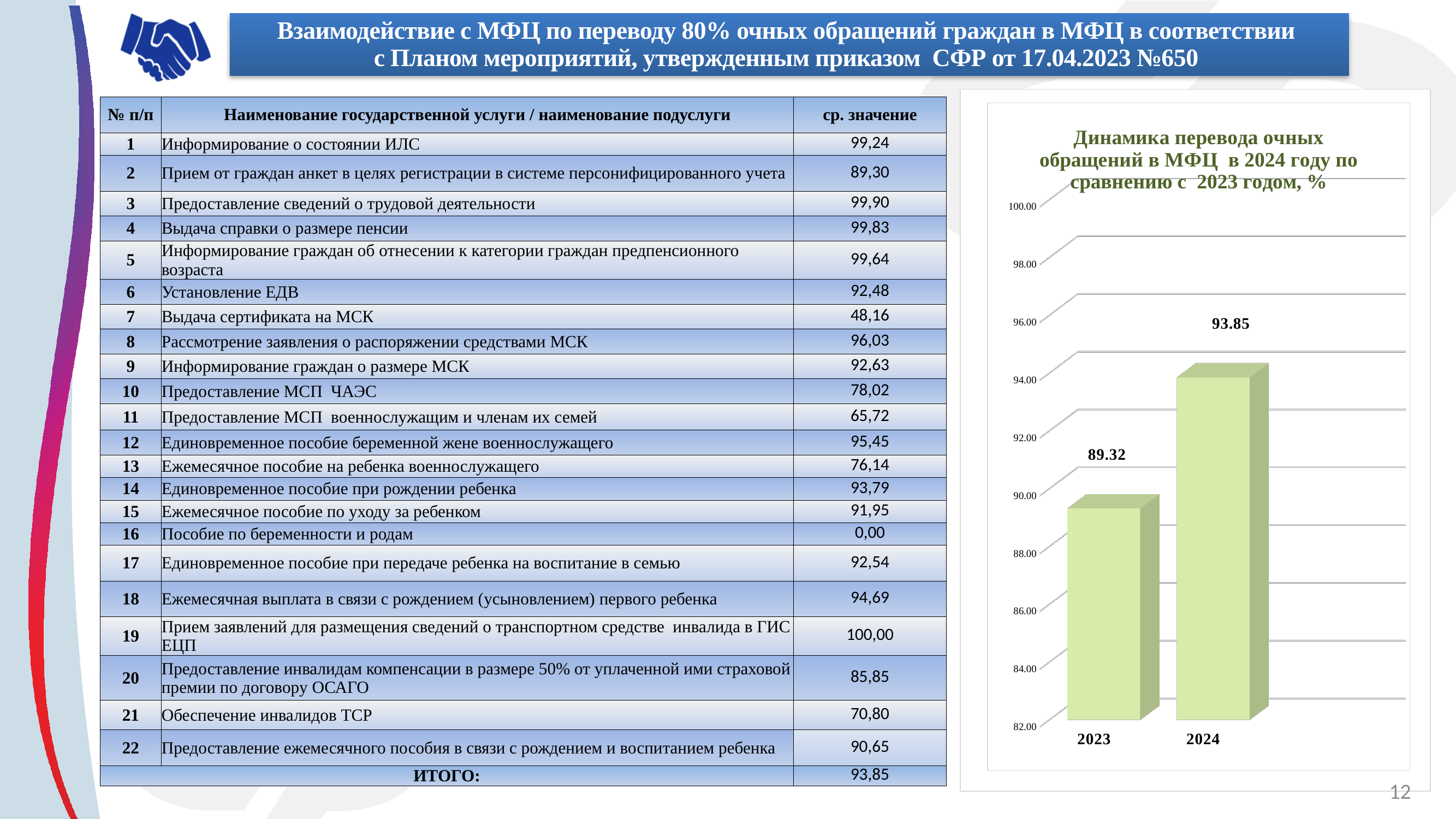
What is the title of the chart? Динамика перевода очных обращений в МФЦ в 2024 году по сравнению с 2023 годом, % What is the value shown for 2023 in the chart? 89.32 What is the value shown for 2024 in the chart? 93.85 How many bars are plotted in the chart? 2 Which year has the higher value in the chart? 2024 By how much does the 2024 value exceed the 2023 value in the chart? 4.53 Is the value for 2023 greater or less than 90.00 on the chart's axis? less Which year has the lower value in the chart? 2023 Do the values in the chart rise or fall from 2023 to 2024? rise What is the lowest value labelled on the chart's vertical axis? 82.00 What type of chart is shown on the slide? bar chart Is the value for 2024 greater or less than 92.00 on the chart's axis? greater